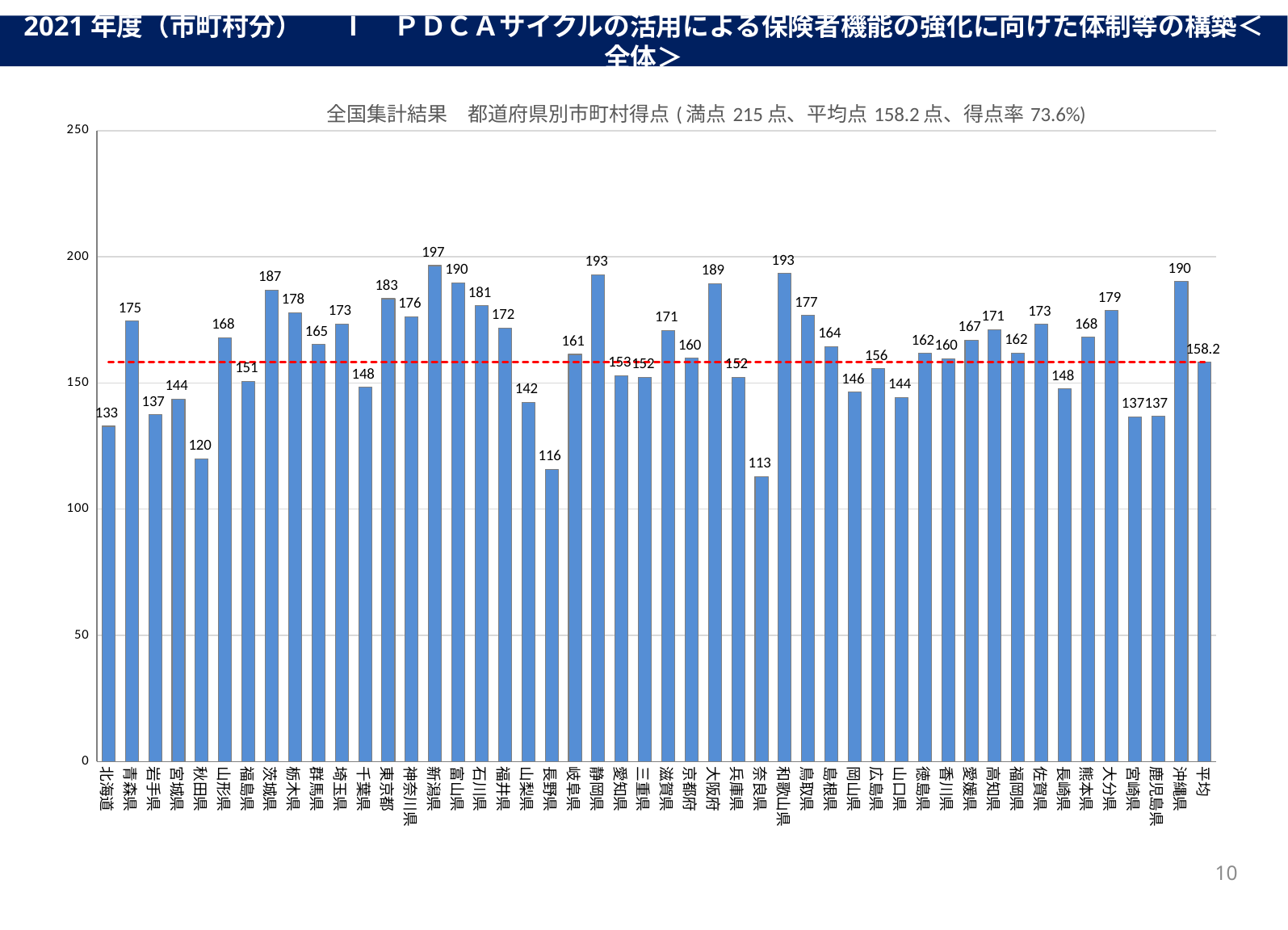
What is the value for 新潟県? 197 What is the value for 奈良県? 113 Which is larger, the value for 茨城県 or the value for 栃木県? 茨城県 How many bars are plotted in the chart, including 平均? 48 What is the difference between the values for 沖縄県 and 鹿児島県? 53 What is the difference between the values for 新潟県 and 奈良県? 84 Which prefecture has the lowest value? 奈良県 What is the value shown for 平均? 158.2 What is the value for 北海道? 133 Which prefecture has the highest value? 新潟県 What value does the red dashed horizontal line represent? 158.2 What kind of chart is shown on the slide? Bar chart